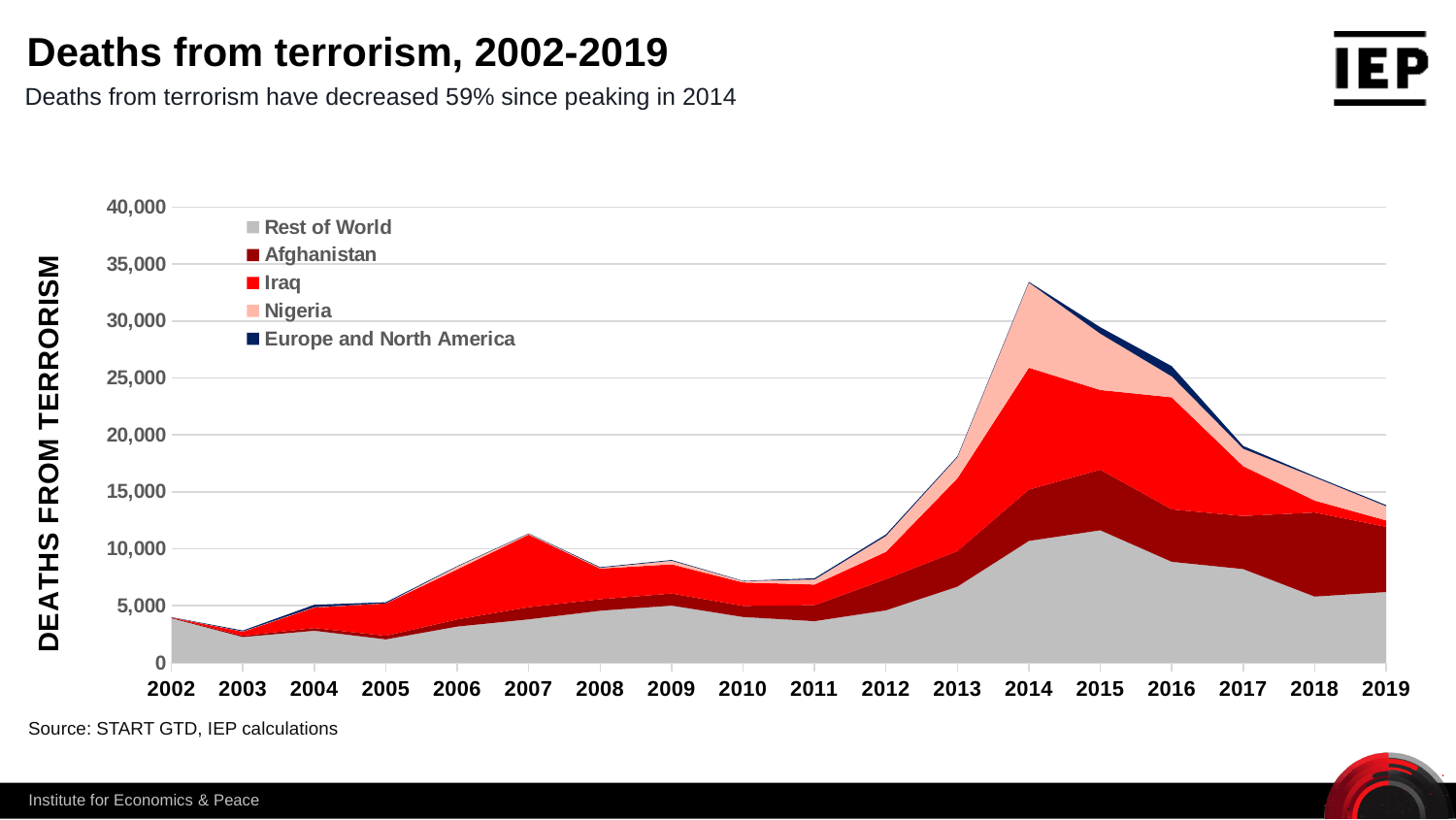
Do total deaths from terrorism rise or fall from 2011 to 2014? rise How many years are shown along the x axis? 18 What is the title of the chart? Deaths from terrorism, 2002-2019 What kind of chart is shown on the slide? Stacked area chart Is the total number of deaths in 2014 greater or less than 30,000? greater In which year is the total number of deaths from terrorism highest? 2014 Is the total number of deaths in 2007 greater or less than 10,000? greater How many series does the legend list? 5 Which year has a higher total of deaths from terrorism, 2013 or 2019? 2013 Is the total number of deaths in 2003 greater or less than 5,000? less In which year is the total number of deaths from terrorism lowest? 2003 Do total deaths from terrorism rise or fall from 2014 to 2019? fall